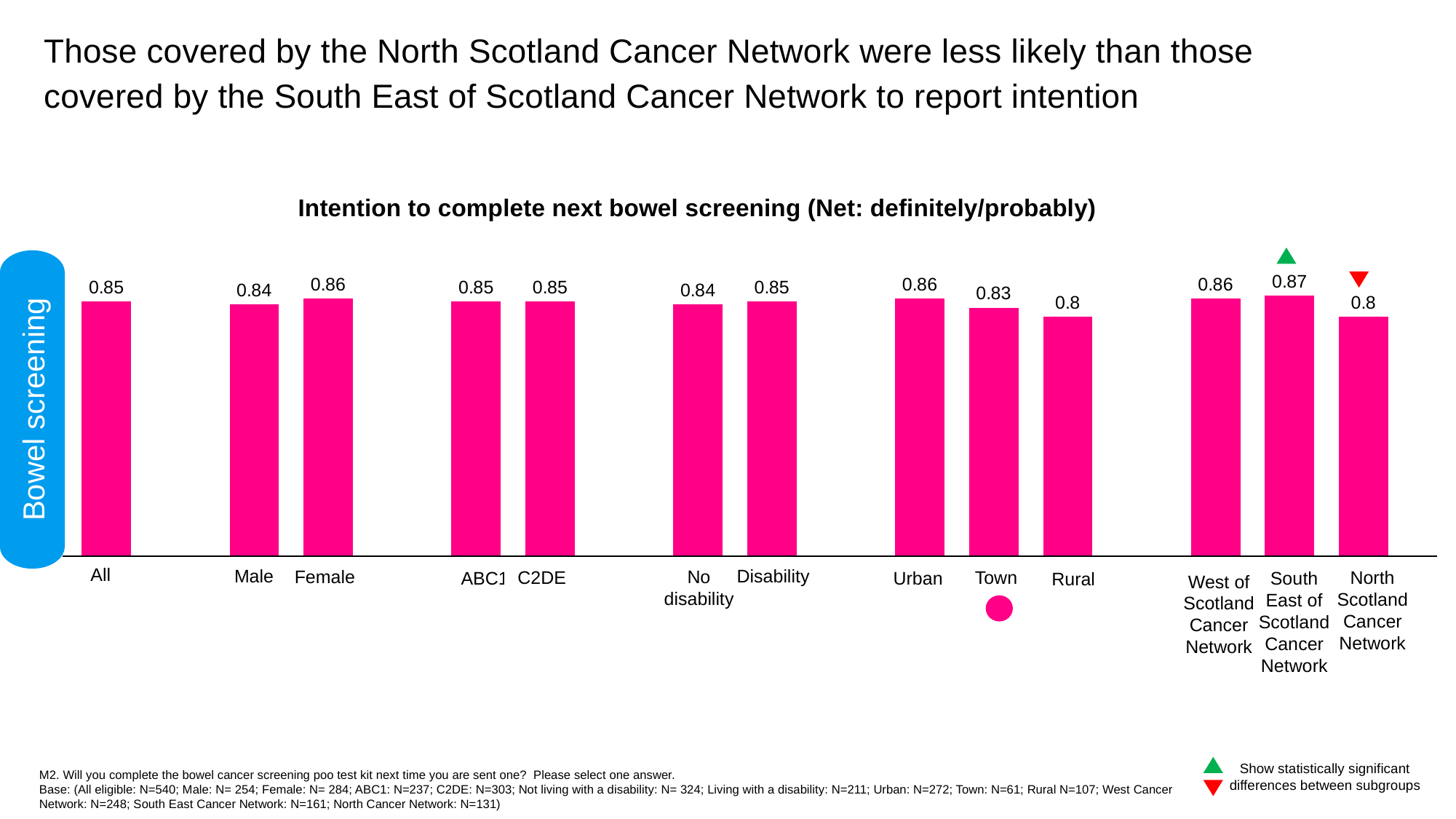
What is the value for Town? 0.83 What is the difference between the Urban and Rural values? 0.06 Which is larger, the value for Female or the value for Male? Female What kind of chart is shown on the slide? Bar chart How many bars are shown in the chart? 13 What is the value for Rural? 0.8 What is the title of the chart? Intention to complete next bowel screening (Net: definitely/probably) What is the difference between the South East of Scotland Cancer Network and the North Scotland Cancer Network values? 0.07 What is the value for No disability? 0.84 What is the value for All? 0.85 What is the value for the South East of Scotland Cancer Network? 0.87 Which category has the highest value? South East of Scotland Cancer Network